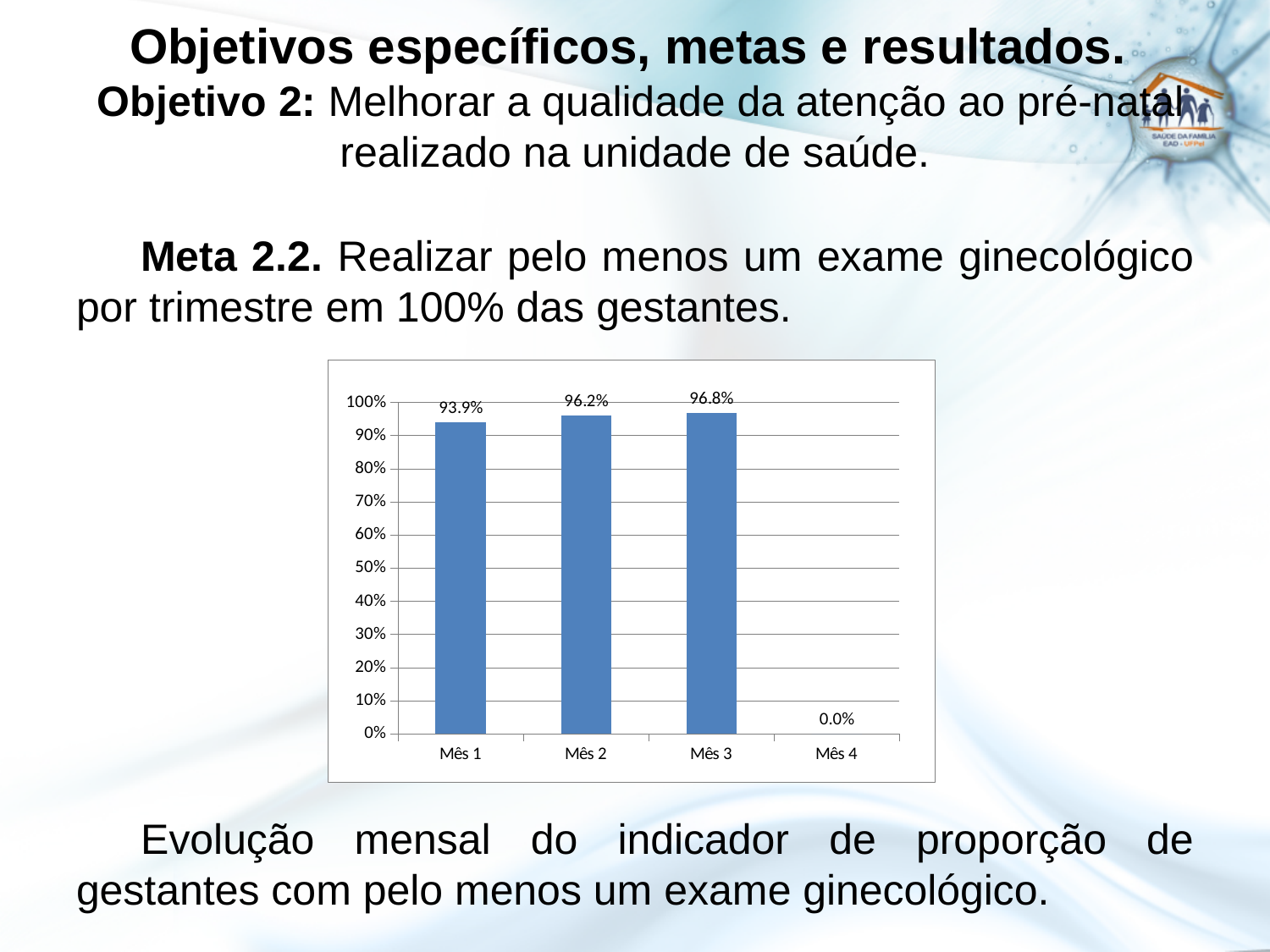
What is the difference between the values for Mês 3 and Mês 1? 2.9% What is the value for Mês 1? 93.9% Which is larger, the value for Mês 1 or the value for Mês 2? Mês 2 Which month has the highest value? Mês 3 What kind of chart is shown on the slide? bar chart What is the value for Mês 3? 96.8% What is the value for Mês 4? 0.0% Do the values rise or fall from Mês 1 to Mês 3? rise Is the value for Mês 1 greater or less than 90%? greater Which month has the lowest value? Mês 4 What is the value for Mês 2? 96.2% How many months are shown on the x axis? 4